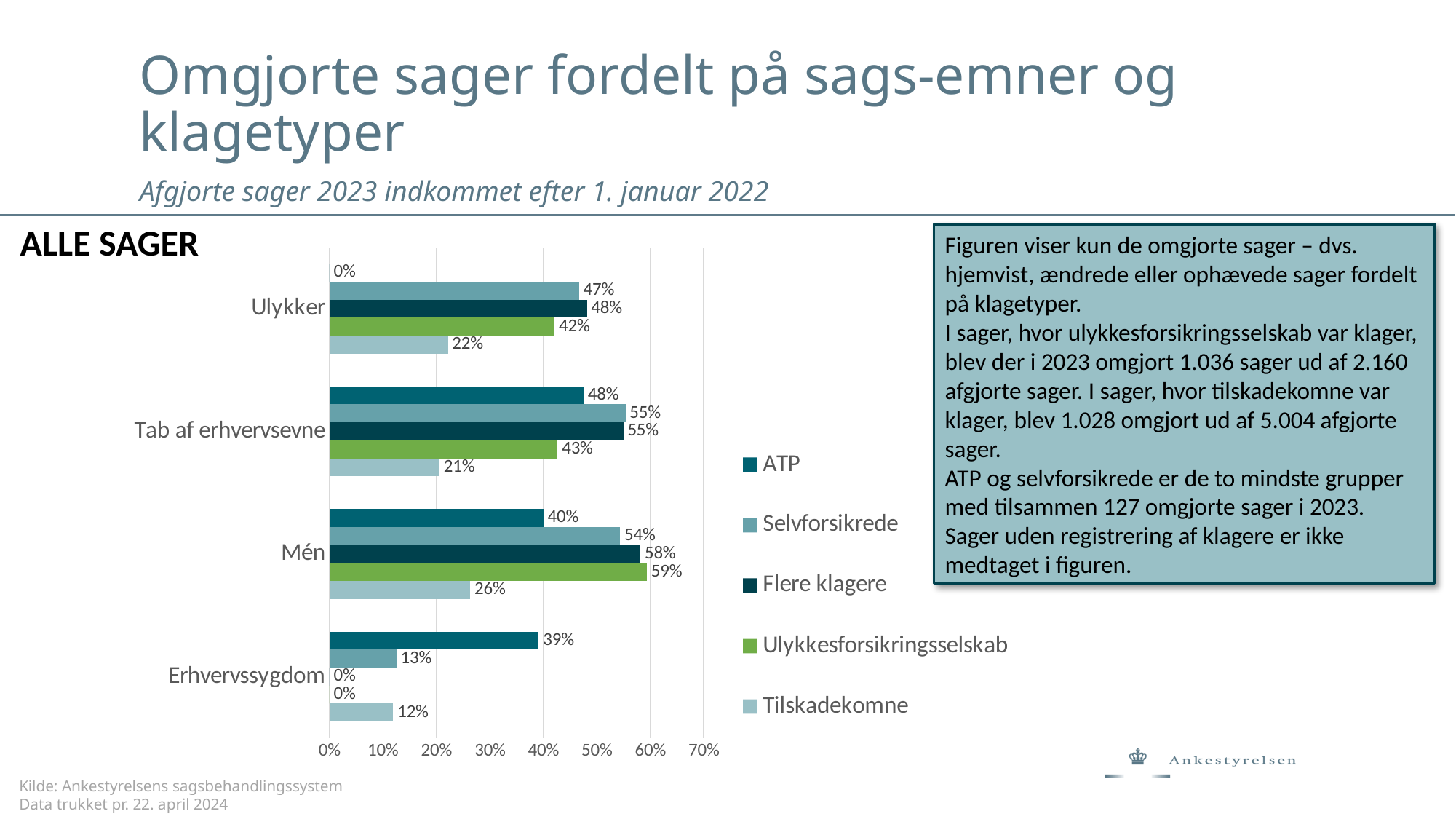
Which is larger in the Erhvervssygdom category: the value for ATP or the value for Selvforsikrede? ATP What is the value for Ulykkesforsikringsselskab in the Tab af erhvervsevne category? 43% How many categories are shown on the y axis of the chart? 4 What is the value for ATP in the Erhvervssygdom category? 39% How many series does the legend list? 5 What is the value for Selvforsikrede in the Ulykker category? 47% Which category has the lowest value for ATP? Ulykker Which category has the highest value for Tilskadekomne? Mén What is the difference between the Flere klagere value and the Tilskadekomne value in the Mén category? 32% What kind of chart is shown on the slide? Bar chart What is the value for Tilskadekomne in the Mén category? 26% What is the heading shown above the chart? ALLE SAGER